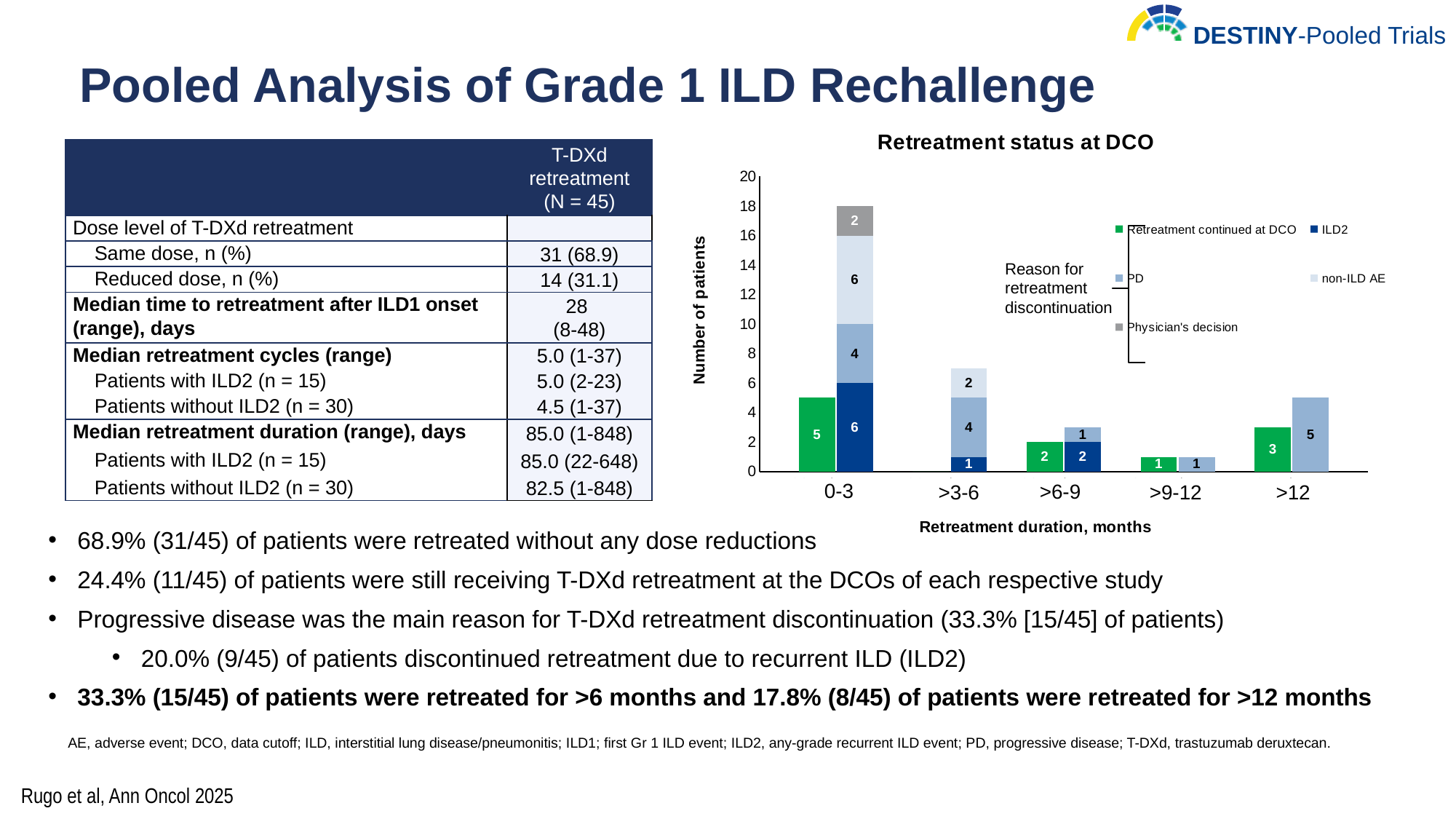
What is the total height of the stacked discontinuation bar for the 0-3 months category? 18 How many retreatment duration categories are shown on the x axis of the chart? 5 What is the x-axis title of the 'Retreatment status at DCO' chart? Retreatment duration, months How many series does the legend of the 'Retreatment status at DCO' chart list? 5 What is the total of the stacked discontinuation bar for the >3-6 months category? 7 What kind of chart is shown under the title 'Retreatment status at DCO'? Bar chart What is the difference between the PD value in the 0-3 months category and the PD value in the >6-9 months category? 3 Which retreatment duration category has the highest ILD2 value? 0-3 In the chart, how many patients in the 0-3 months category discontinued due to ILD2? 6 Which category has the larger 'Retreatment continued at DCO' value, 0-3 or >12? 0-3 In the chart, how many patients in the >12 months category discontinued due to PD? 5 In the chart, what is the value for 'Retreatment continued at DCO' in the >12 months category? 3